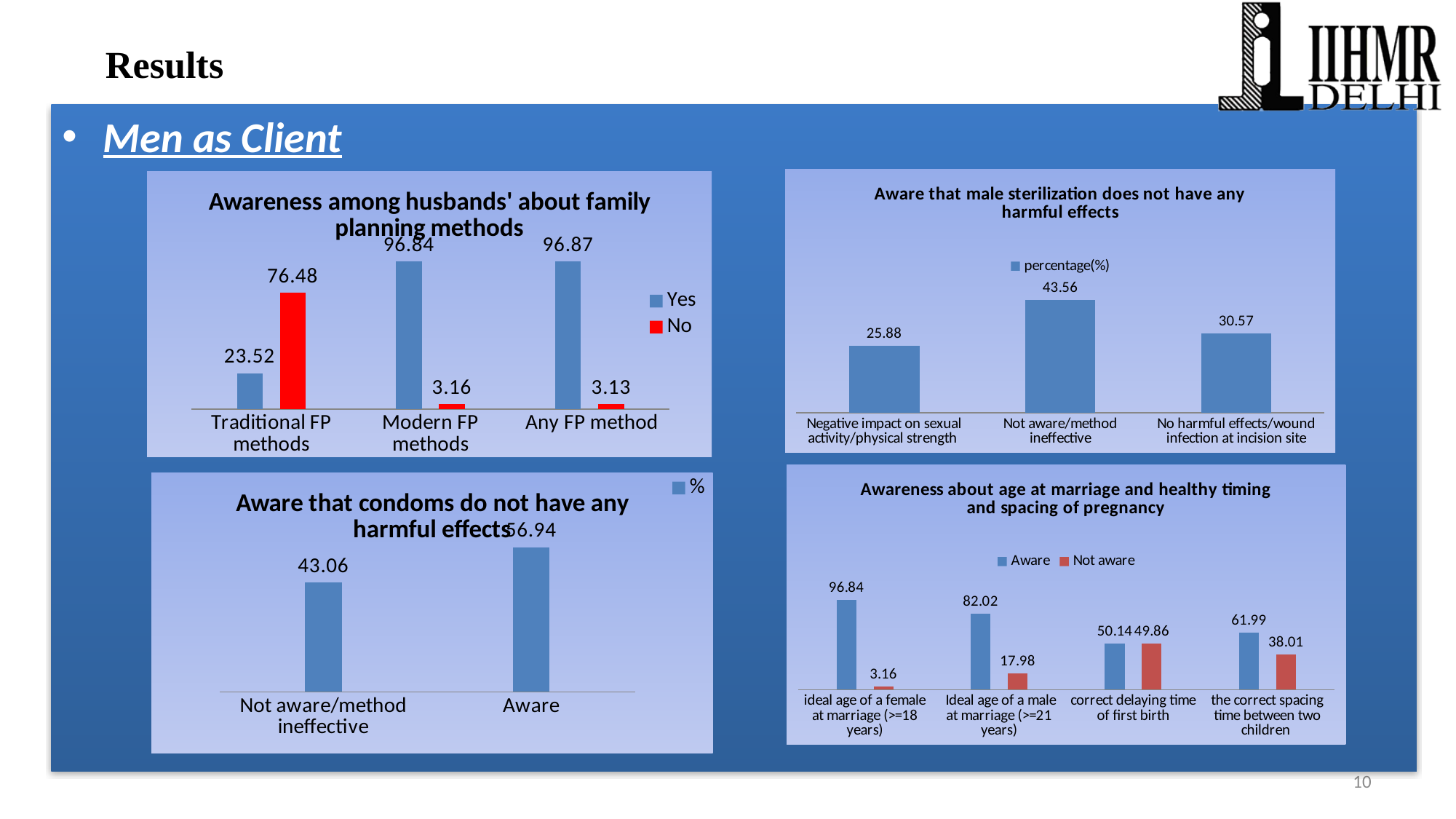
In the chart titled 'Aware that male sterilization does not have any harmful effects', how many categories are shown? 3 In the chart titled 'Aware that condoms do not have any harmful effects', what is the difference between the 'Aware' and 'Not aware/method ineffective' values? 13.88 In the chart titled 'Awareness about age at marriage and healthy timing and spacing of pregnancy', which is larger for 'the correct spacing time between two children': Aware or Not aware? Aware In the chart titled 'Awareness among husbands' about family planning methods', what is the 'Yes' value for Modern FP methods? 96.84 In the chart titled 'Awareness among husbands' about family planning methods', what is the 'No' value for Traditional FP methods? 76.48 In the chart titled 'Awareness among husbands' about family planning methods', how many series does the legend list? 2 In the chart titled 'Aware that male sterilization does not have any harmful effects', what is the value for 'No harmful effects/wound infection at incision site'? 30.57 What type of chart is the one titled 'Aware that condoms do not have any harmful effects'? Bar chart In the chart titled 'Aware that condoms do not have any harmful effects', what is the value for 'Aware'? 56.94 In the chart titled 'Awareness about age at marriage and healthy timing and spacing of pregnancy', which category has the lowest 'Aware' value? correct delaying time of first birth In the chart titled 'Aware that male sterilization does not have any harmful effects', which category has the highest value? Not aware/method ineffective In the chart titled 'Awareness about age at marriage and healthy timing and spacing of pregnancy', what is the 'Not aware' value for 'Ideal age of a male at marriage (>=21 years)'? 17.98